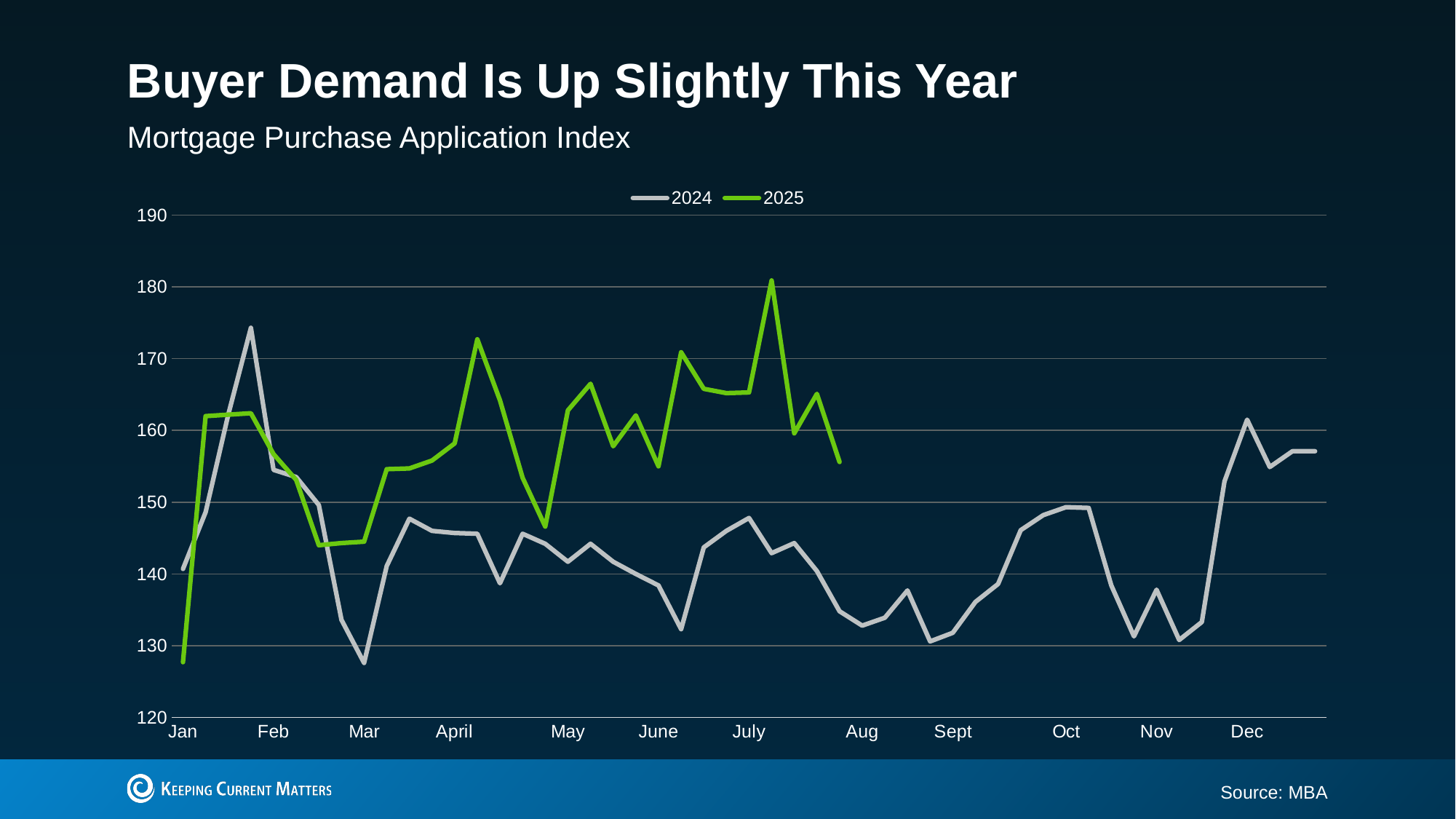
Which two years are listed in the legend? 2024 and 2025 Which series reaches the highest value on the chart, 2024 or 2025? 2025 In which month does the 2025 line reach its peak? July What is the subtitle describing the index plotted on the chart? Mortgage Purchase Application Index In which month does the 2024 line reach its peak? Jan How many series does the legend list? 2 Does the 2025 line rise or fall from January to February? rise What kind of chart is shown on the slide? line chart Is the lowest value of the 2024 line in March greater or less than 130? less In July, which series has the higher value, 2024 or 2025? 2025 How many month labels are shown on the x axis? 12 Is the peak value of the 2025 line in July greater or less than 170? greater